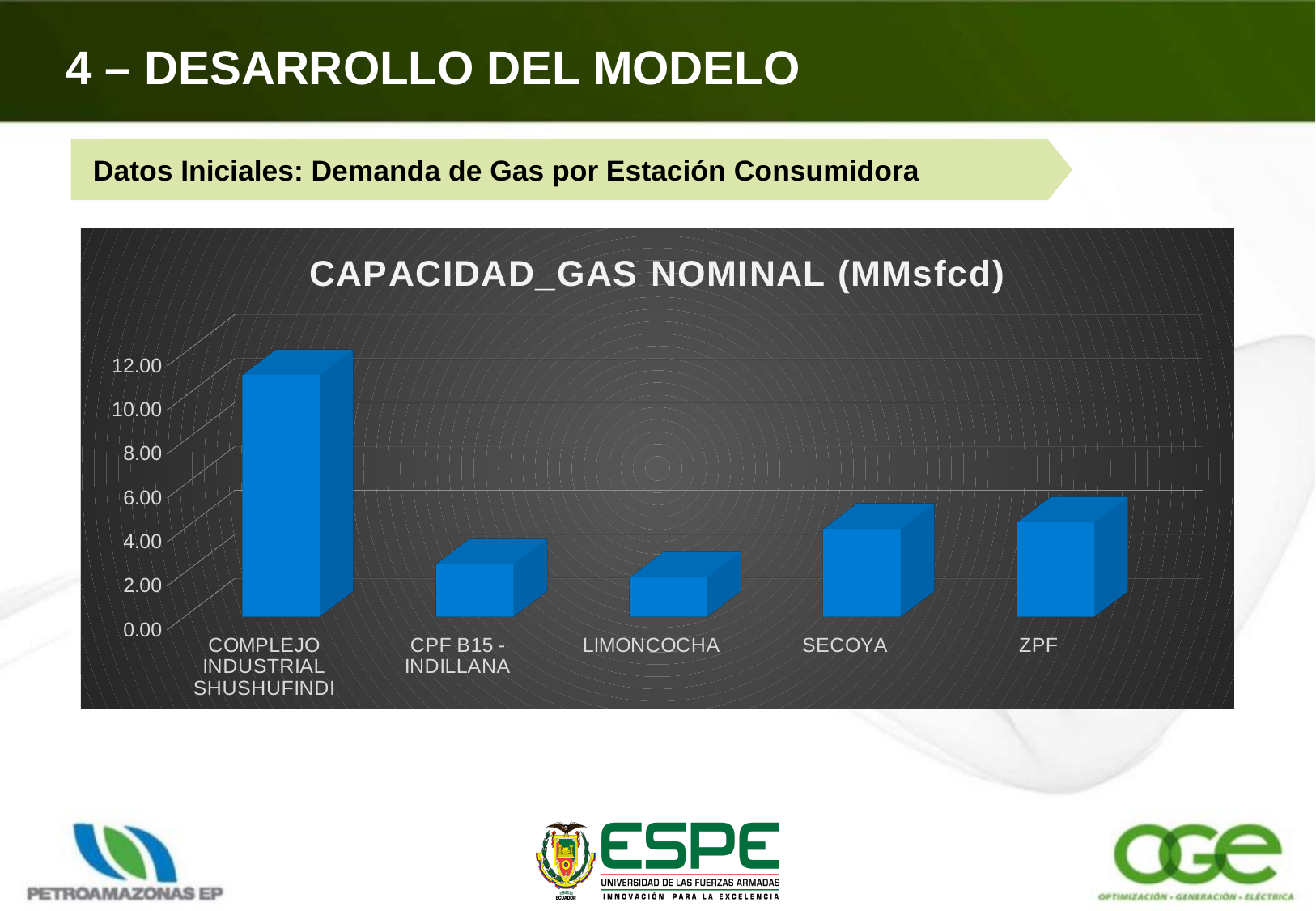
What is the title of the chart? CAPACIDAD_GAS NOMINAL (MMsfcd) How many stations (categories) are plotted in the chart? 5 Is the value for CPF B15 - INDILLANA greater or less than 4.00? less Which station has the highest nominal gas capacity? COMPLEJO INDUSTRIAL SHUSHUFINDI Is the value for SECOYA greater or less than 6.00? less Which station has the lowest nominal gas capacity? LIMONCOCHA Is the value for ZPF greater or less than 2.00? greater Which is larger, the value for COMPLEJO INDUSTRIAL SHUSHUFINDI or the value for SECOYA? COMPLEJO INDUSTRIAL SHUSHUFINDI Which is larger, the value for CPF B15 - INDILLANA or the value for ZPF? ZPF What colour are the bars in the chart? blue What type of chart is shown on the slide? bar chart